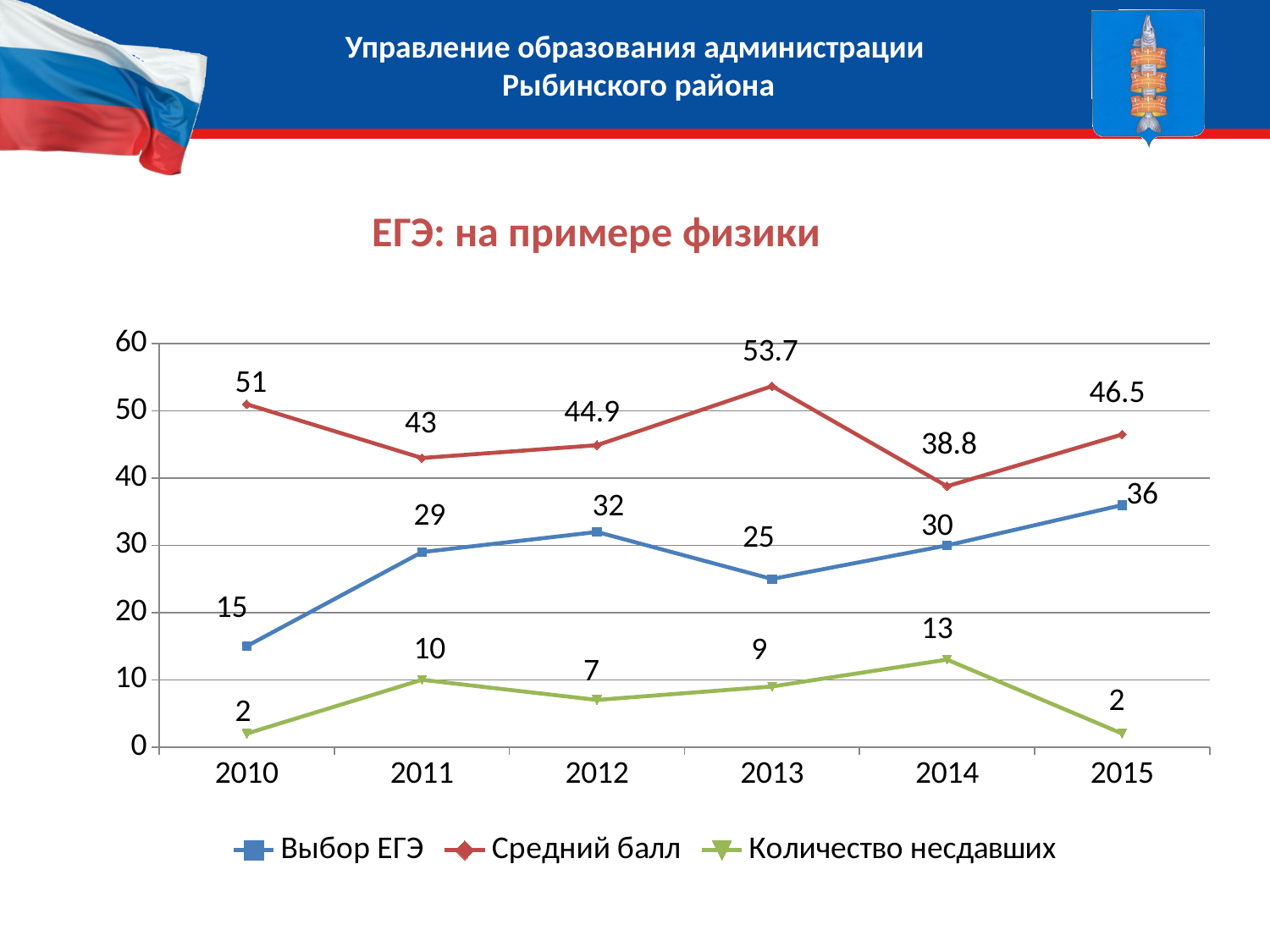
Which is larger: Выбор ЕГЭ in 2012 or in 2013? 2012 What is the value of Количество несдавших in 2014? 13 Does Выбор ЕГЭ rise or fall from 2013 to 2015? rise What is the title of the chart? ЕГЭ: на примере физики What is the difference between Средний балл in 2013 and in 2014? 14.9 How many series does the legend list? 3 In which year is Выбор ЕГЭ the highest? 2015 What type of chart is shown on the slide? line chart What is the value of Средний балл in 2013? 53.7 How many years are plotted along the x axis? 6 In which year is Средний балл the lowest? 2014 What is the value of Выбор ЕГЭ in 2010? 15